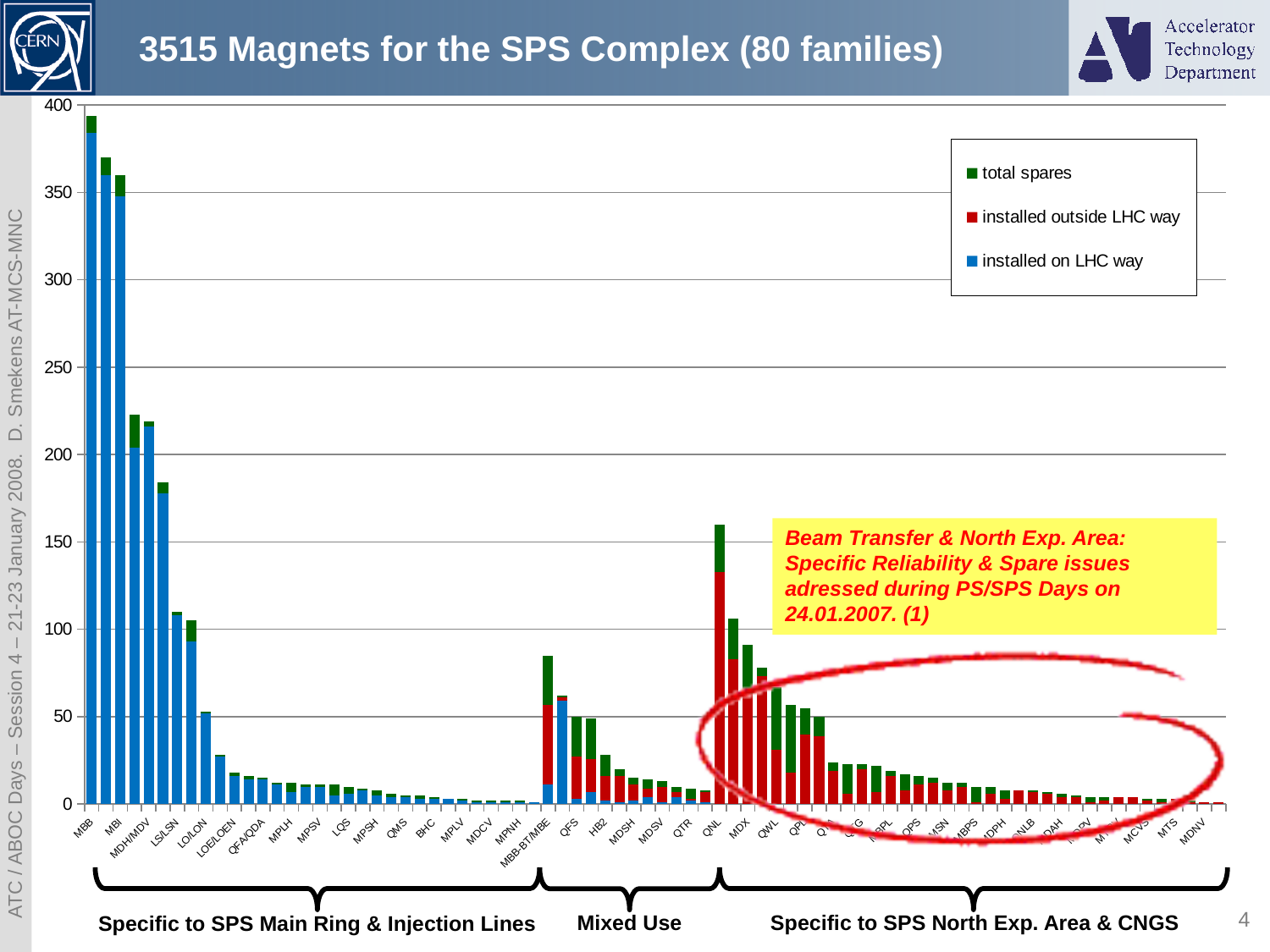
What kind of chart is shown on the slide? bar chart Is the total value for MDX greater or less than 150? less How many series does the chart's legend list? 3 Is the total value for QFS greater or less than 100? less According to the chart title, how many magnet families are covered? 80 families Which has the larger total bar, MBB or QNL? MBB Which series in the legend is shown in green? total spares Is the total value for QNL greater or less than 150? greater Which category has the highest total bar in the chart? MBB